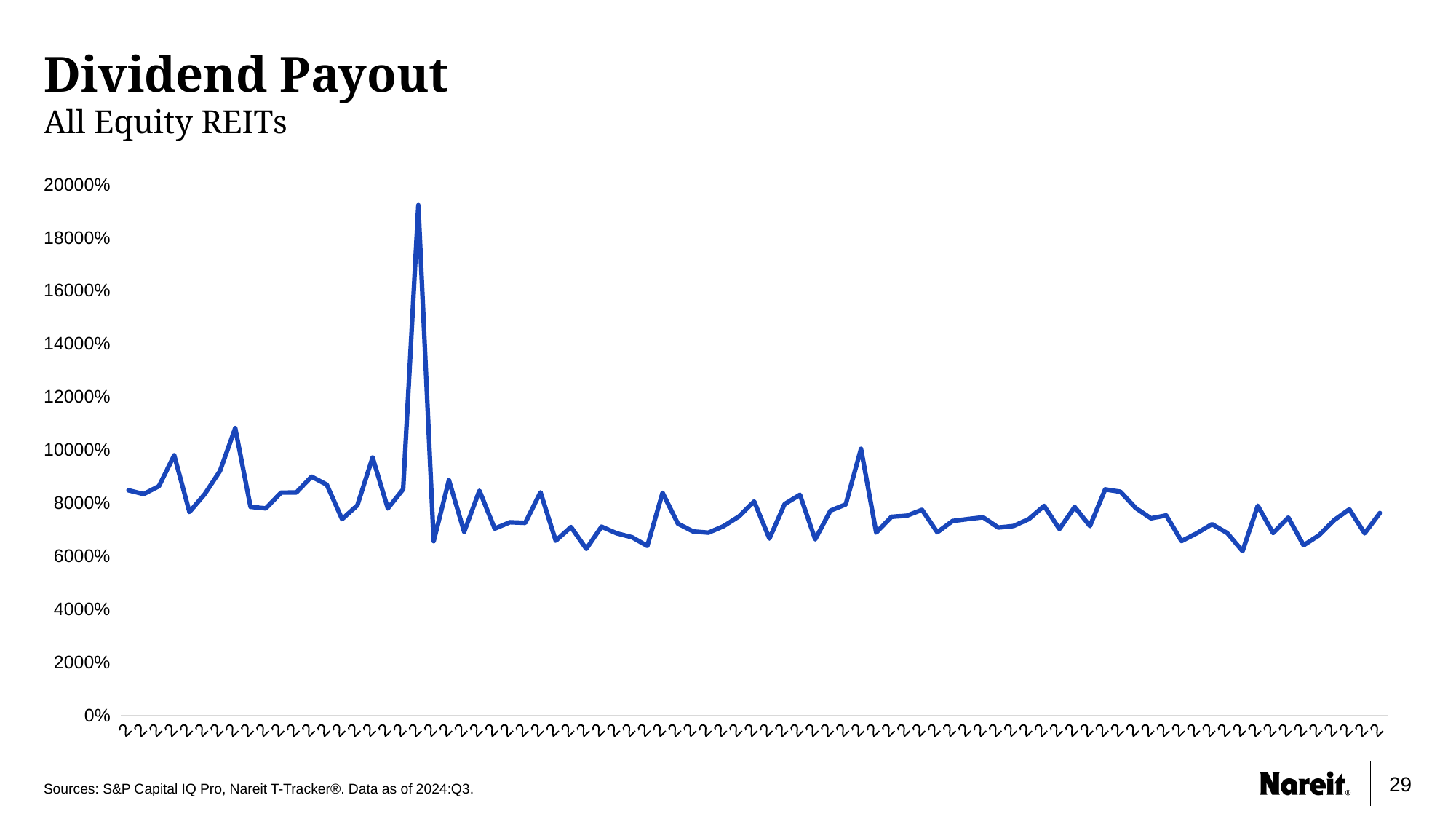
What kind of chart is shown on the slide? line chart Is the lowest point on the line greater or less than 4000%? greater Is the second-highest peak on the line (near the left side) greater or less than 10000%? greater Is the highest point on the line greater or less than 20000%? less How many data series are plotted on the chart? 1 What is the title of the chart on the slide? Dividend Payout What colour is the plotted line? blue